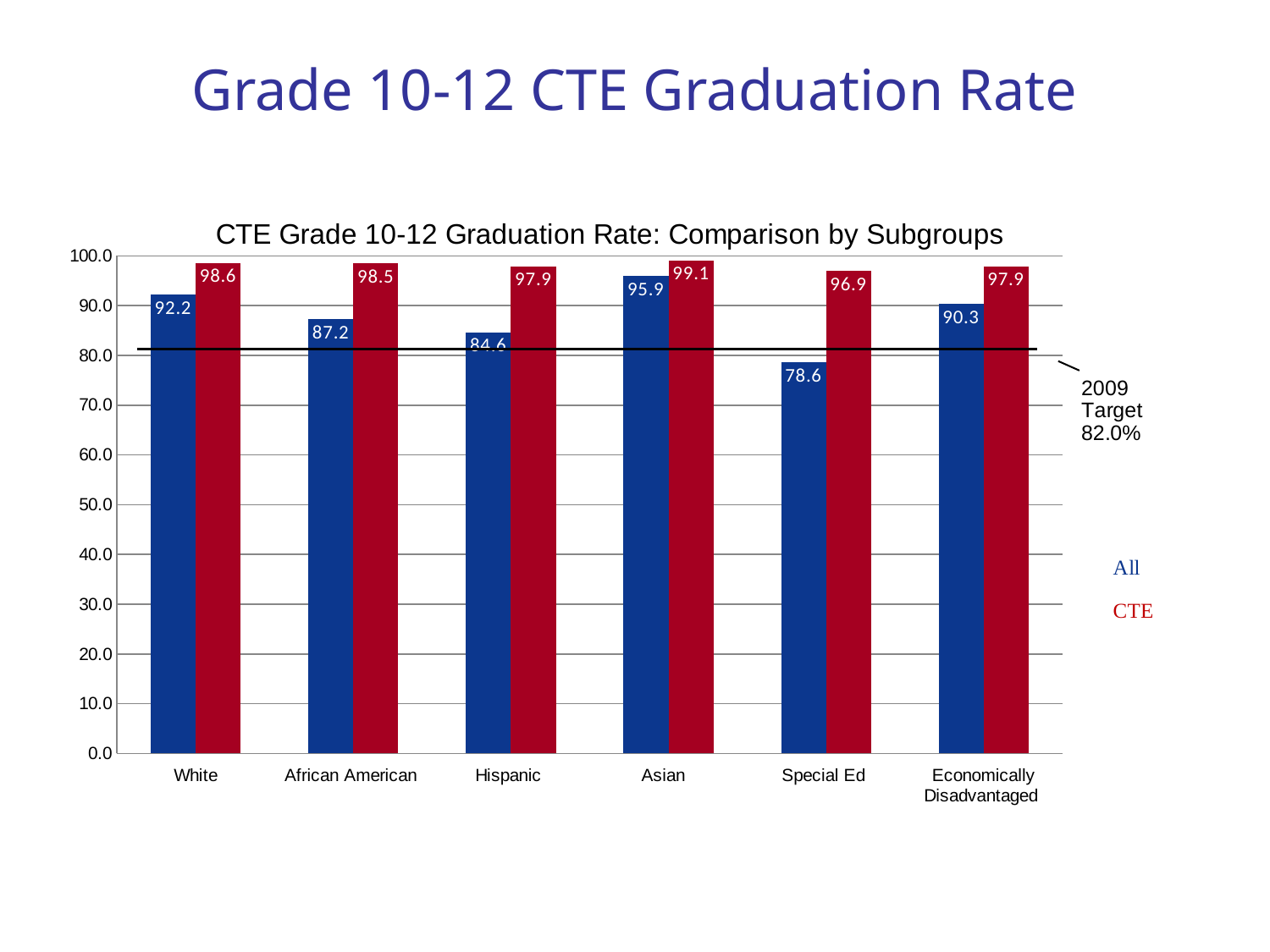
What is the difference between the CTE and All graduation rates for Special Ed students? 18.3 What is the All graduation rate for Special Ed students? 78.6 Which is larger, the All graduation rate for African American students or for Economically Disadvantaged students? Economically Disadvantaged Which subgroup has the lowest All graduation rate? Special Ed Is the All graduation rate for Special Ed students greater or less than 80.0? less What is the CTE graduation rate for Asian students? 99.1 What is the CTE graduation rate for Economically Disadvantaged students? 97.9 What is the All graduation rate for White students? 92.2 How many subgroups are shown on the x axis? 6 Which subgroup has the highest CTE graduation rate? Asian What is the 2009 Target value marked by the horizontal line? 82.0% How many series does the legend list? 2